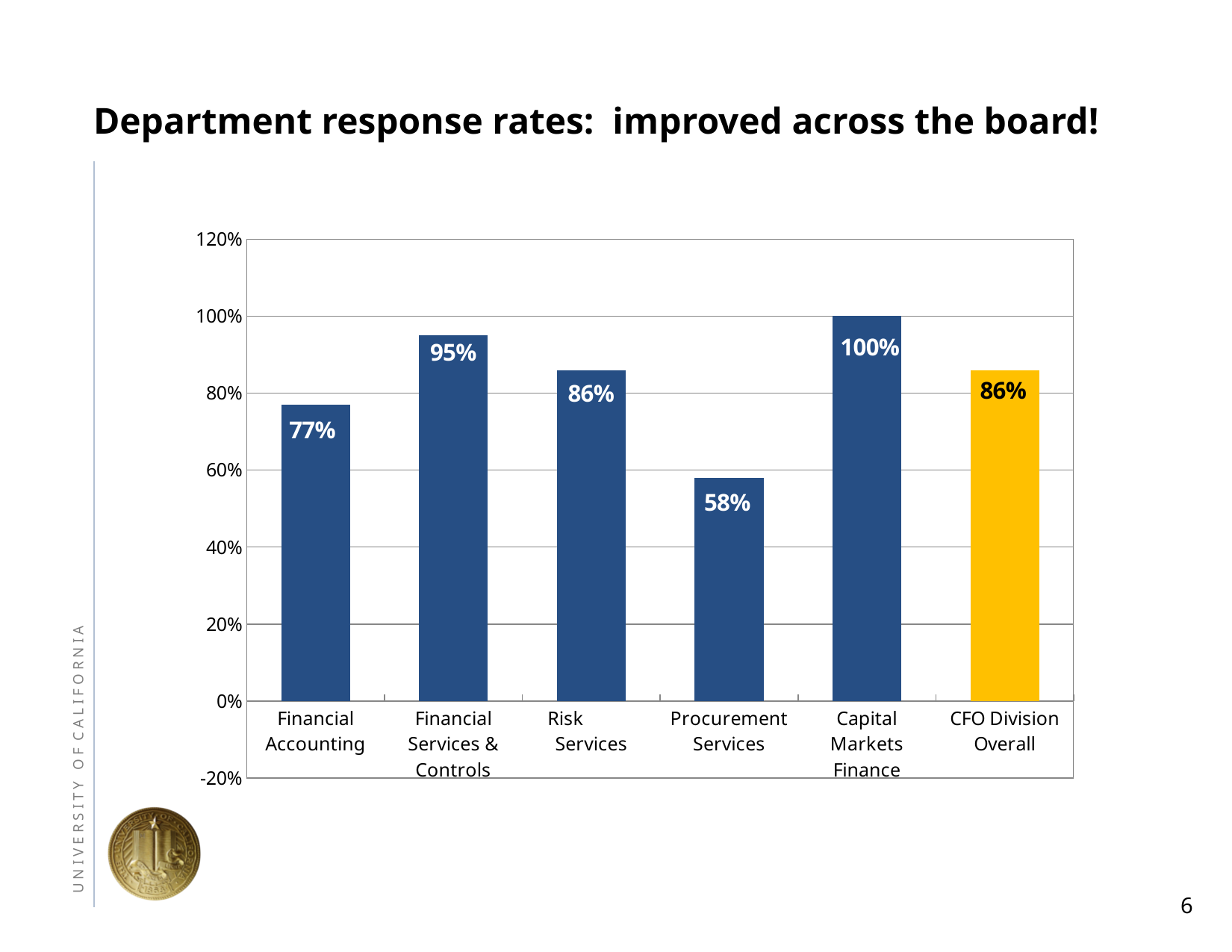
What is the response rate for Financial Accounting? 77% What kind of chart is shown on the slide? bar chart Which category has the highest response rate? Capital Markets Finance What is the difference between the response rates of Financial Services & Controls and Financial Accounting? 18% Which has a higher response rate, Risk Services or Financial Accounting? Risk Services Which category has the lowest response rate? Procurement Services Is the value for Procurement Services greater or less than 60%? less What is the response rate for Procurement Services? 58% What is the response rate for CFO Division Overall? 86% What is the difference between the response rates of Capital Markets Finance and Procurement Services? 42% Which bar is coloured differently (gold) from the others? CFO Division Overall How many categories are shown on the x axis? 6